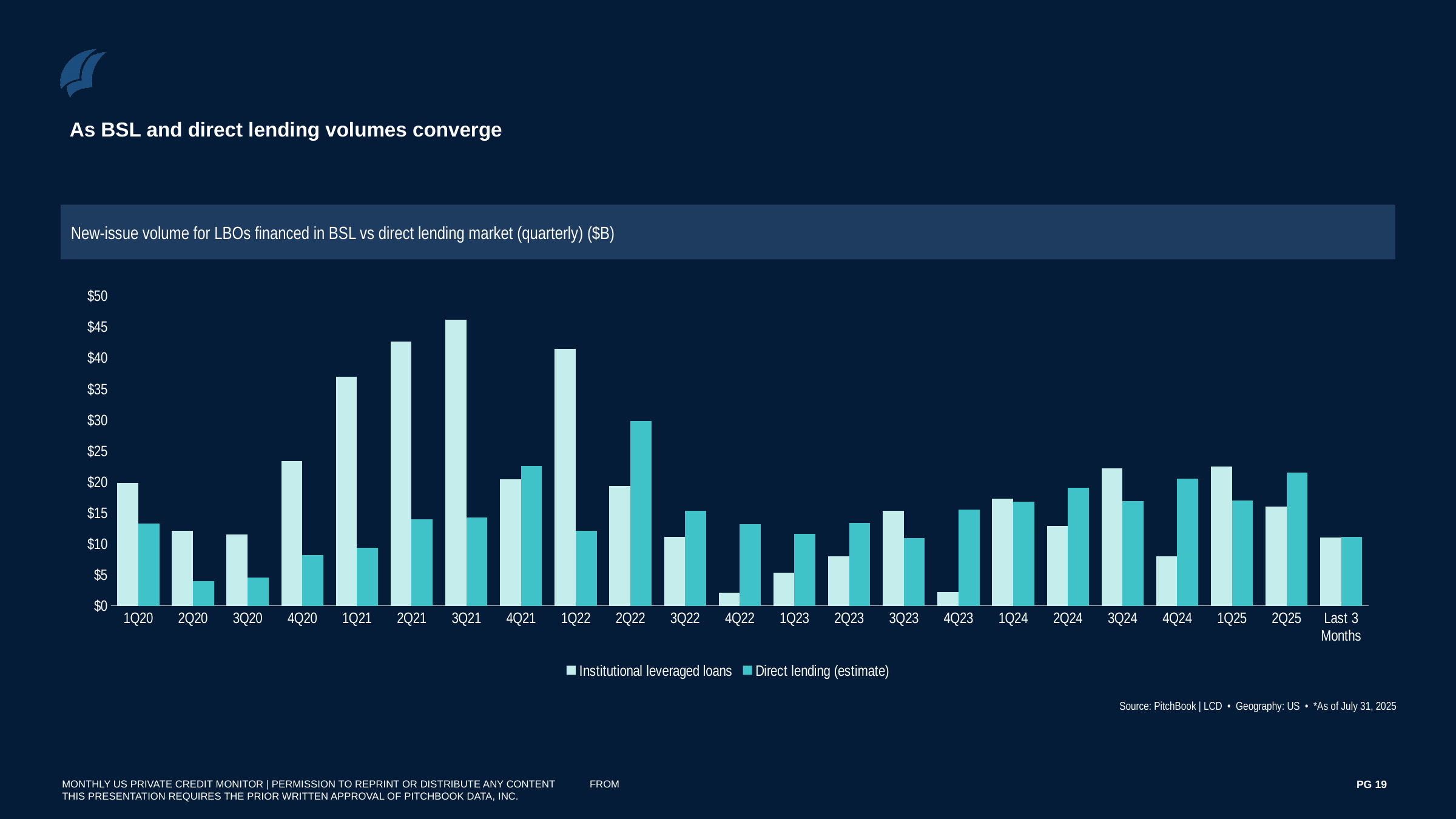
How many categories are shown on the x axis? 23 In which quarter is the Institutional leveraged loans value highest? 3Q21 Is the Institutional leveraged loans value for 3Q21 greater or less than $40? greater Is the Direct lending (estimate) value for 2Q20 greater or less than $5? less What is the title of the chart? New-issue volume for LBOs financed in BSL vs direct lending market (quarterly) ($B) In 4Q24, which is larger: Institutional leveraged loans or Direct lending (estimate)? Direct lending (estimate) In which quarter is the Direct lending (estimate) value highest? 2Q22 How many series does the legend list? 2 In 2Q22, which is larger: Institutional leveraged loans or Direct lending (estimate)? Direct lending (estimate) Do the Institutional leveraged loans values rise or fall from 1Q22 to 4Q22? fall What kind of chart is shown on the slide? Bar chart Is the Institutional leveraged loans value for 4Q22 greater or less than $5? less